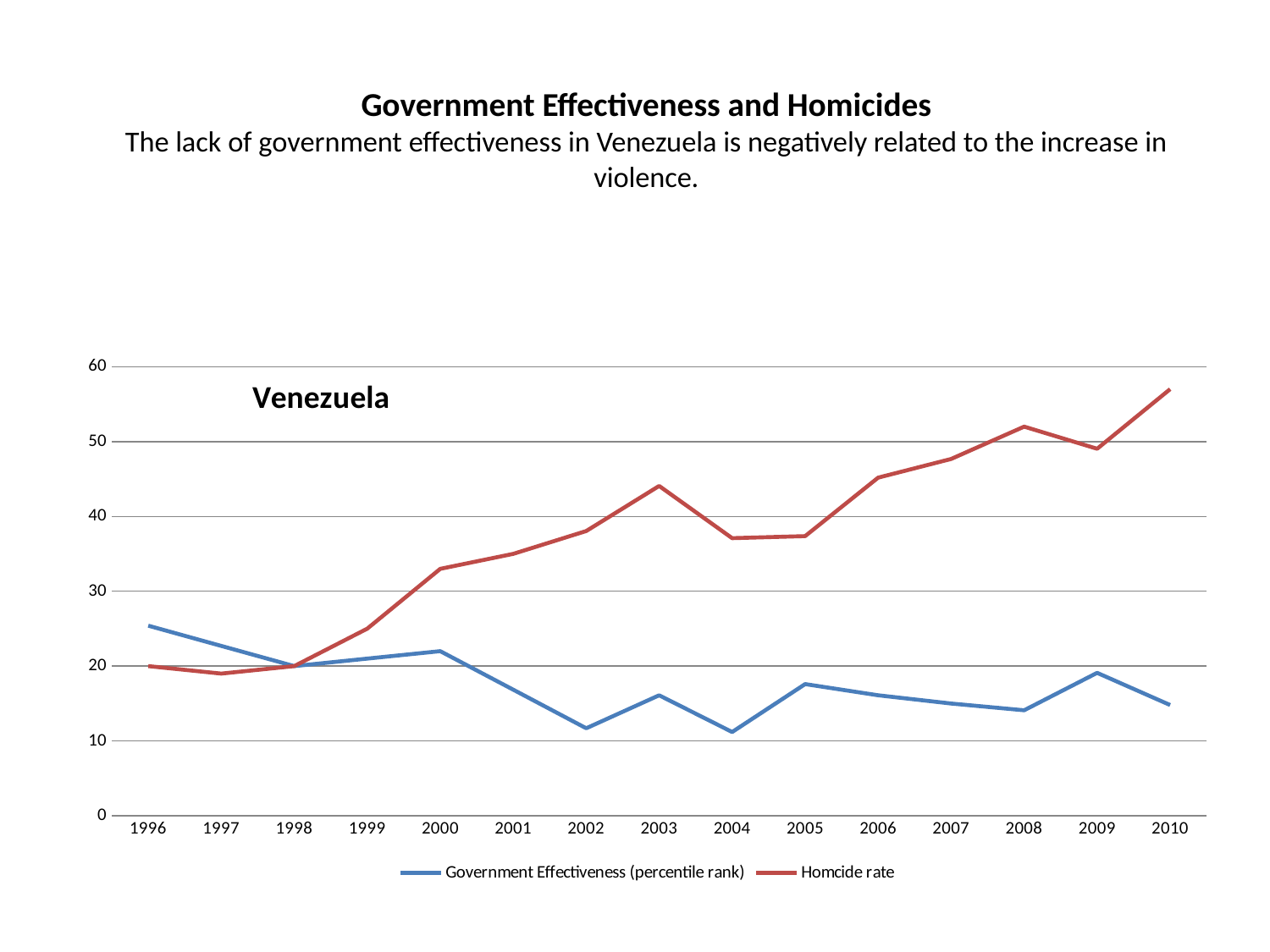
Is the Homcide rate in 2003 greater or less than 40? greater What country name is printed inside the chart area? Venezuela In 2010, which series has the larger value, Government Effectiveness (percentile rank) or Homcide rate? Homcide rate Is the Homcide rate in 1999 greater or less than 30? less Does the Homcide rate generally rise or fall from 1996 to 2010? rise Is the Government Effectiveness (percentile rank) in 2002 greater or less than 20? less In which year is Government Effectiveness (percentile rank) highest? 1996 In which year is the Homcide rate highest? 2010 How many years are plotted along the x axis? 15 How many series does the legend list? 2 What kind of chart is shown on the slide? line chart